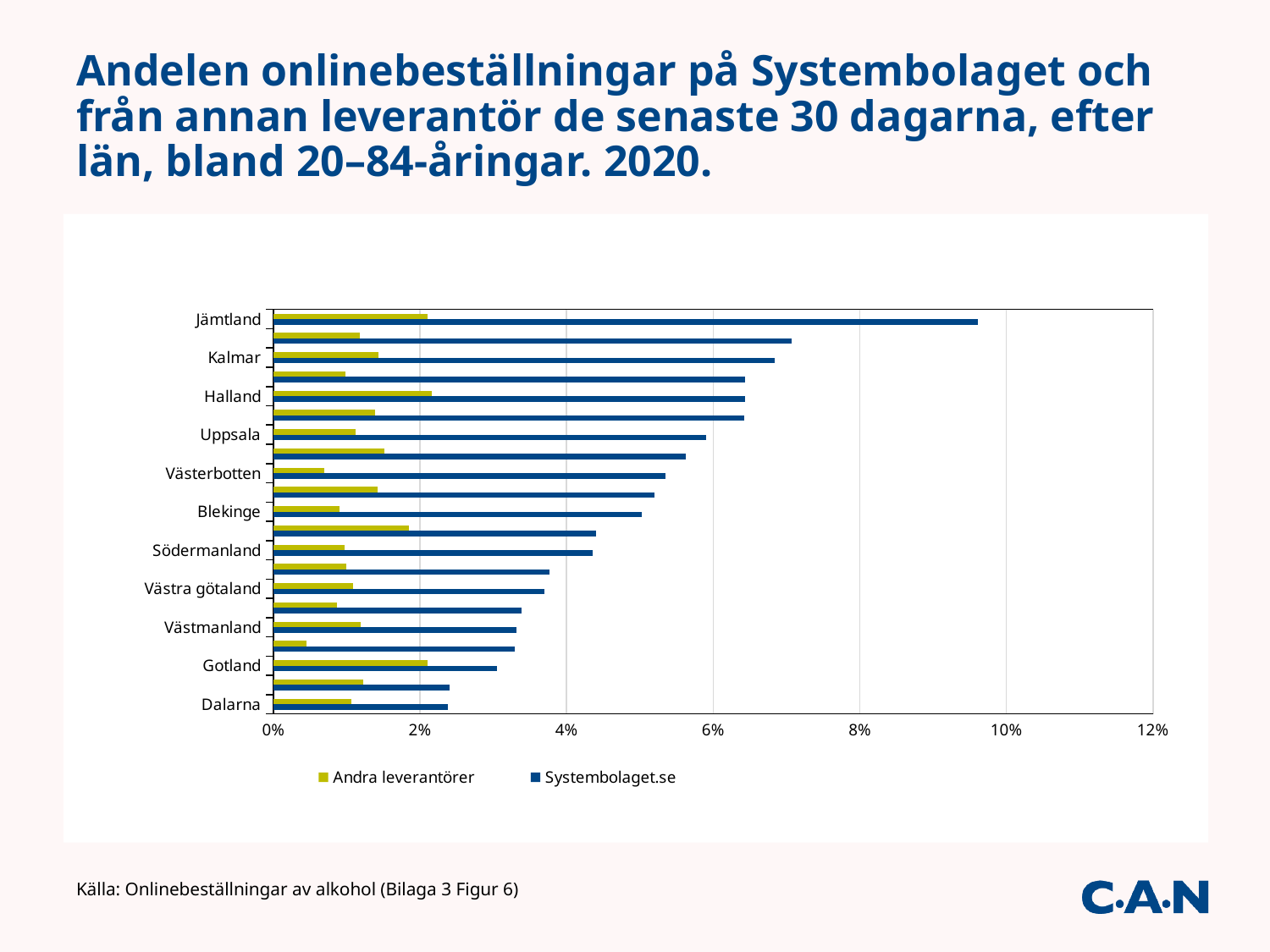
What are the two series named in the legend? Andra leverantörer and Systembolaget.se What kind of chart is shown on the slide? Bar chart Is the Systembolaget.se value for Jämtland greater or less than 8%? greater Is the Systembolaget.se value for Kalmar greater or less than 6%? greater Is the Andra leverantörer value for Jämtland greater or less than 4%? less Which has the larger Systembolaget.se value, Jämtland or Dalarna? Jämtland Do the Systembolaget.se values rise or fall going from Jämtland at the top down to Dalarna at the bottom? fall Which county has the highest value for Systembolaget.se? Jämtland How many series does the legend list? 2 Which labelled county has the lowest value for Systembolaget.se? Dalarna Which has the larger Andra leverantörer value, Halland or Västerbotten? Halland